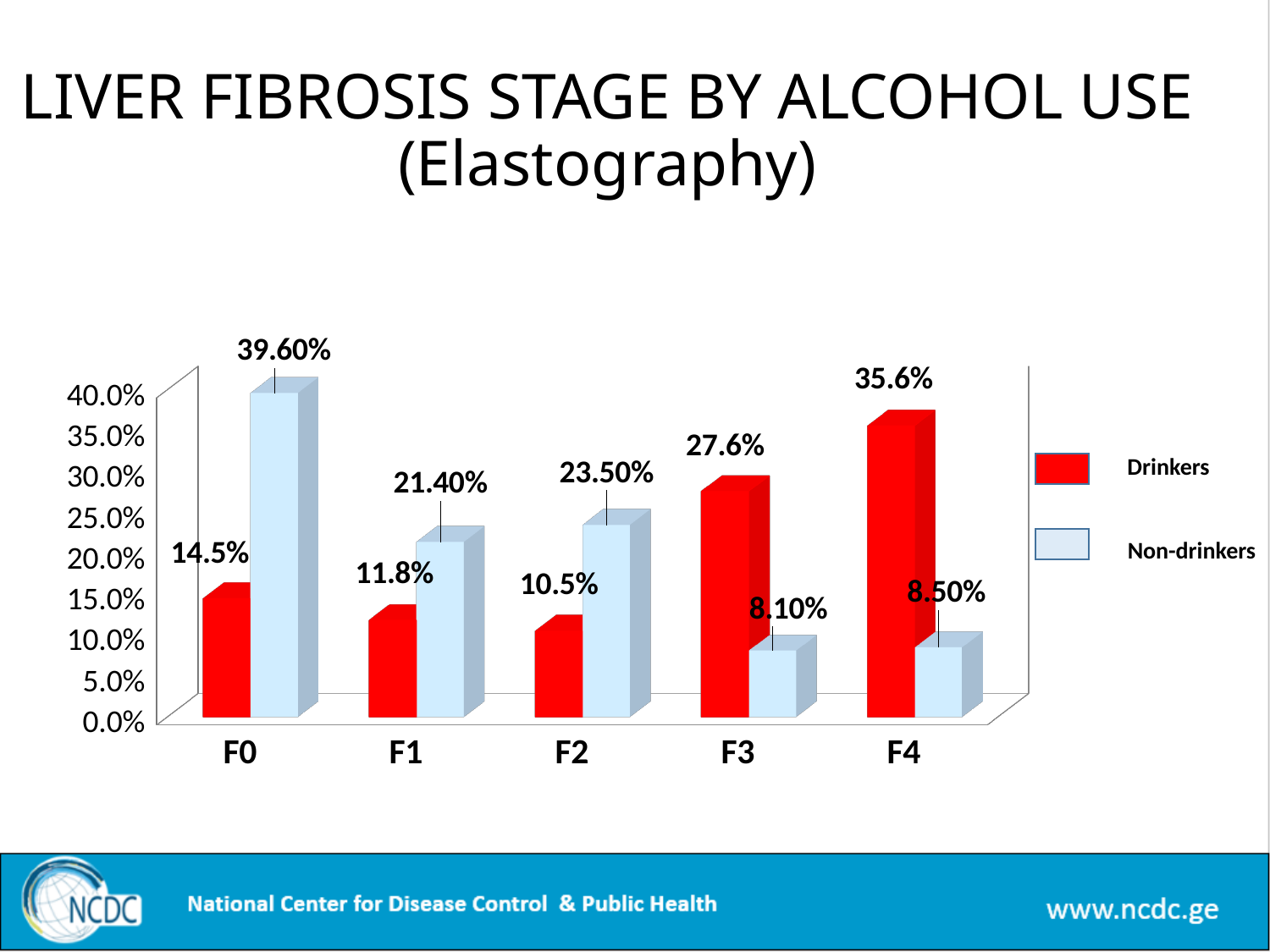
What is the difference between the Non-drinkers and Drinkers values at stage F0? 25.1 percentage points Which fibrosis stage has the highest value for Drinkers? F4 What is the value for Drinkers at stage F4? 35.6% What is the value for Non-drinkers at stage F3? 8.10% Which colour represents Non-drinkers in the chart? Light blue At stage F3, which group has the larger value, Drinkers or Non-drinkers? Drinkers What is the value for Non-drinkers at stage F0? 39.60% Which fibrosis stage has the lowest value for Non-drinkers? F3 What kind of chart is shown on the slide? Bar chart How many series does the legend list? 2 How many fibrosis stages are shown on the x axis? 5 What is the value for Drinkers at stage F2? 10.5%